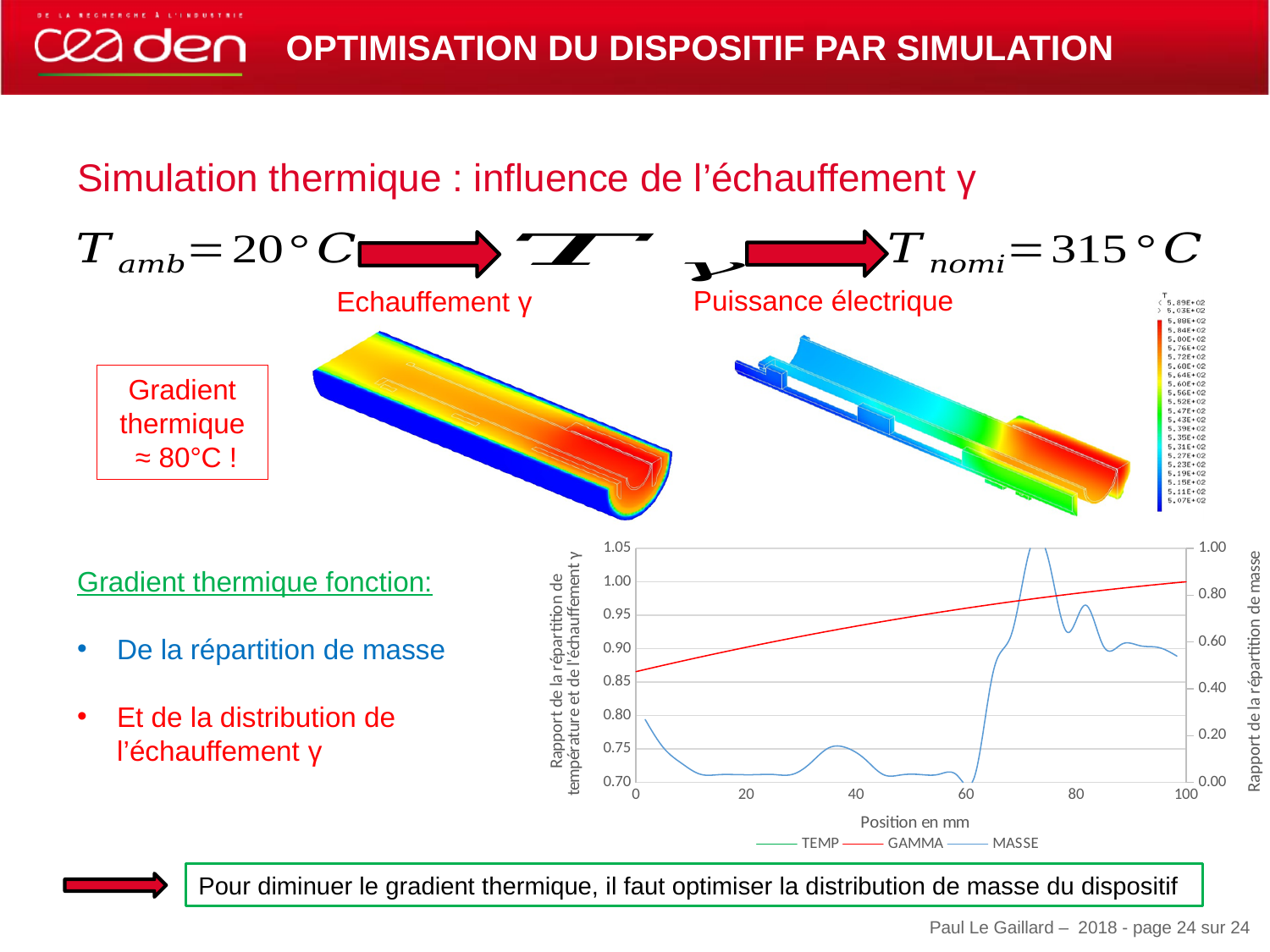
What kind of chart is shown at the bottom right of the slide? line chart What is the highest tick value shown on the left y axis of the line chart? 1.05 On the left axis of the line chart, is the value of the red line at position 0 greater or less than 0.90? less What is the label of the x axis of the line chart? Position en mm What is the largest position value shown on the x axis of the line chart? 100 Does the red line in the chart rise or fall as the position increases from 0 to 100 mm? rises On the left axis of the line chart, is the value of the red line at position 40 greater or less than 0.90? greater What are the three series names listed in the legend of the line chart? TEMP, GAMMA, MASSE How many tick labels are shown on the x axis of the line chart? 6 How many series does the legend of the line chart list? 3 What is the highest tick value shown on the right y axis of the line chart? 1.00